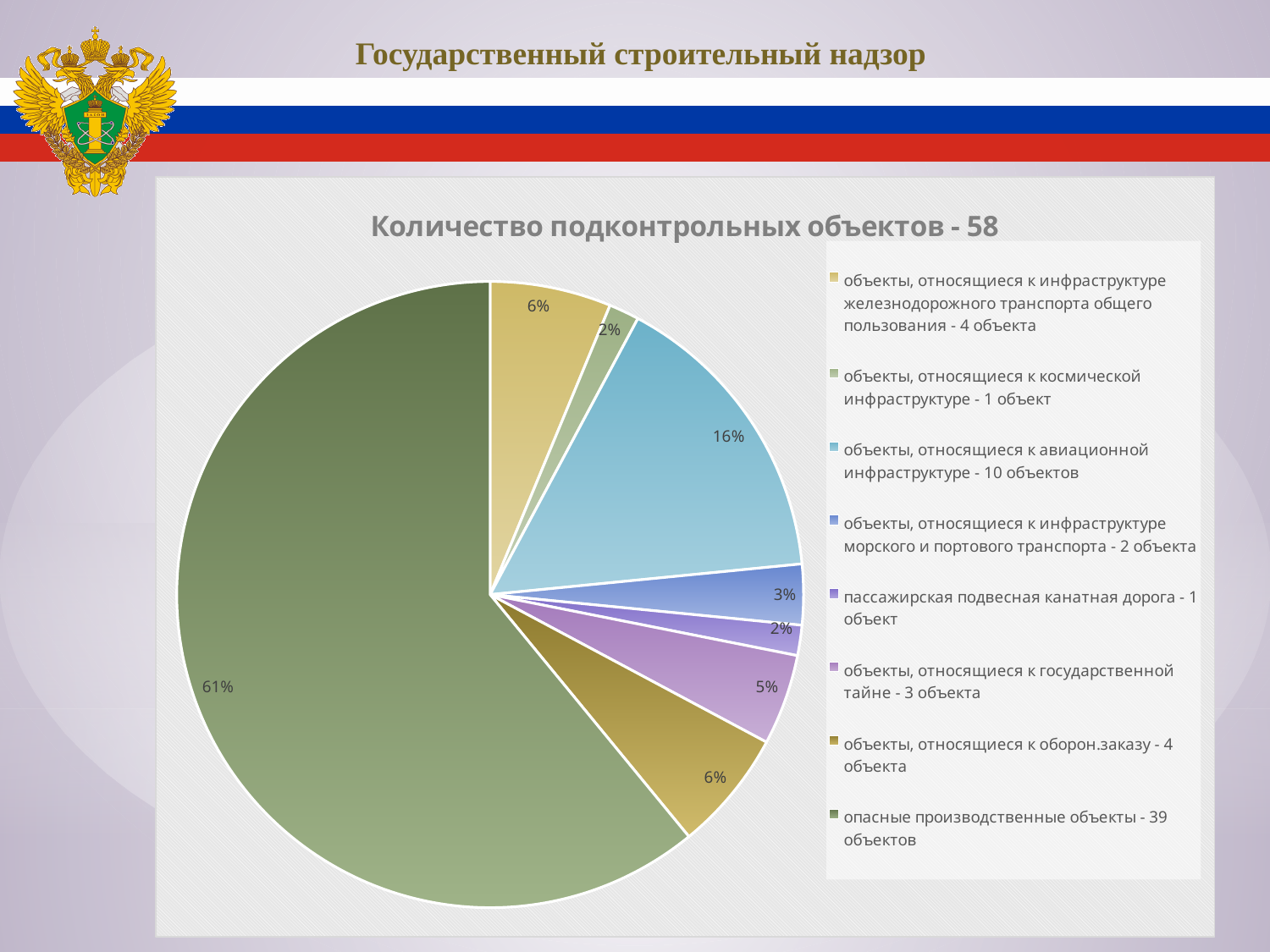
How many objects belong to the category объекты, относящиеся к авиационной инфраструктуре, according to the legend? 10 What share of the pie is taken by объекты, относящиеся к авиационной инфраструктуре? 16% What share of the pie is taken by опасные производственные объекты? 61% What share of the pie is taken by объекты, относящиеся к государственной тайне? 5% What is the difference in percentage points between the slice for опасные производственные объекты and the slice for объекты, относящиеся к авиационной инфраструктуре? 45 percentage points How many objects belong to the category опасные производственные объекты, according to the legend? 39 Which slice is larger: объекты, относящиеся к авиационной инфраструктуре or объекты, относящиеся к оборон.заказу? объекты, относящиеся к авиационной инфраструктуре What kind of chart is shown on the slide? pie chart What is the title of the chart? Количество подконтрольных объектов - 58 Which category has the largest slice of the pie? опасные производственные объекты How many slices does the pie chart have? 8